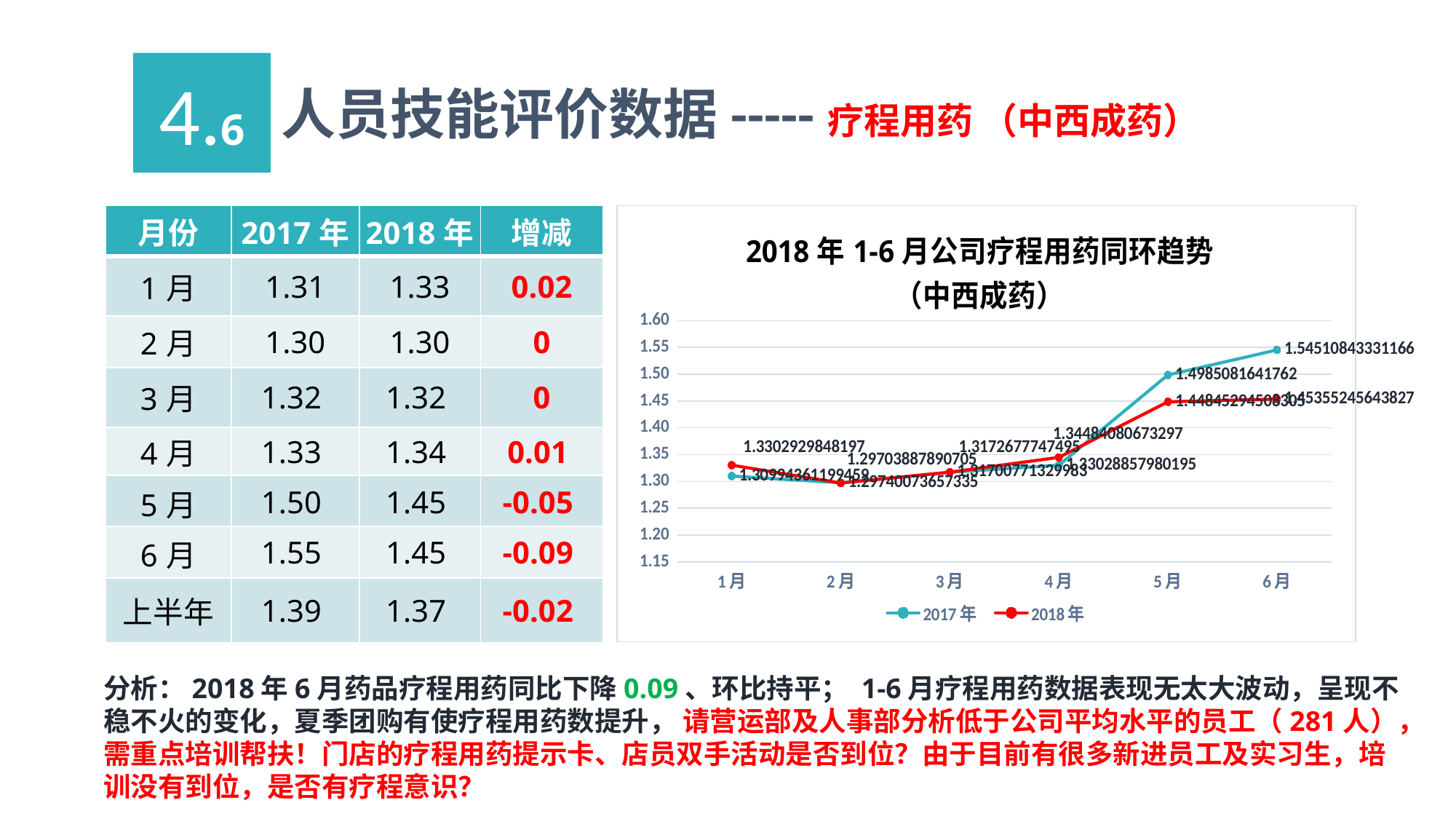
In which month does the 2017年 series reach its lowest value? 2月 What is the title of the chart? 2018年1-6月公司疗程用药同环趋势（中西成药） What is the data label for 2018年 at 1月 in the chart? 1.3302929848197 What is the data label for 2017年 at 6月 in the chart? 1.54510843331166 How many months are plotted along the x axis of the chart? 6 In which month does the 2017年 series reach its highest value? 6月 What is the data label for 2017年 at 5月 in the chart? 1.4985081641762 Is the value for 2018年 at 6月 greater or less than 1.40? greater At 6月, which series has the higher value, 2017年 or 2018年? 2017年 How many series does the chart legend list? 2 What kind of chart is shown on the slide? line chart What is the data label for 2018年 at 4月 in the chart? 1.34484080673297